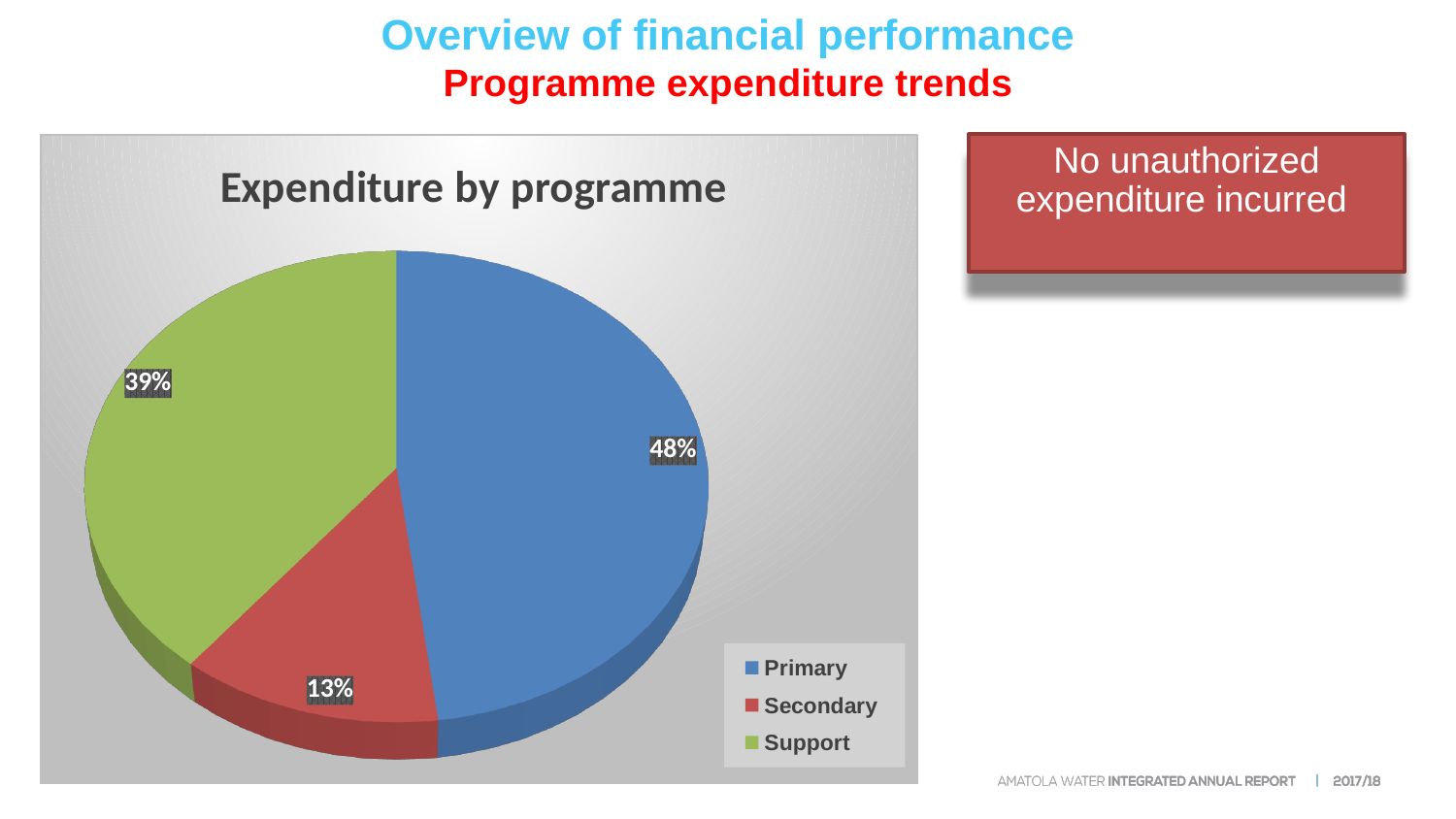
Which programme has the largest share of expenditure? Primary What is the title of the chart? Expenditure by programme What share of expenditure does the Primary programme account for? 48% What kind of chart is shown on the slide? Pie chart How many programmes are shown in the pie chart? 3 What share of expenditure does the Support programme account for? 39% Which programme has the smallest share of expenditure? Secondary What is the difference in percentage points between the Support and Secondary shares? 26 percentage points Which colour represents the Support programme in the pie chart? Green What is the difference in percentage points between the Primary and Support shares? 9 percentage points Which is larger, the Support share or the Secondary share? Support What share of expenditure does the Secondary programme account for? 13%